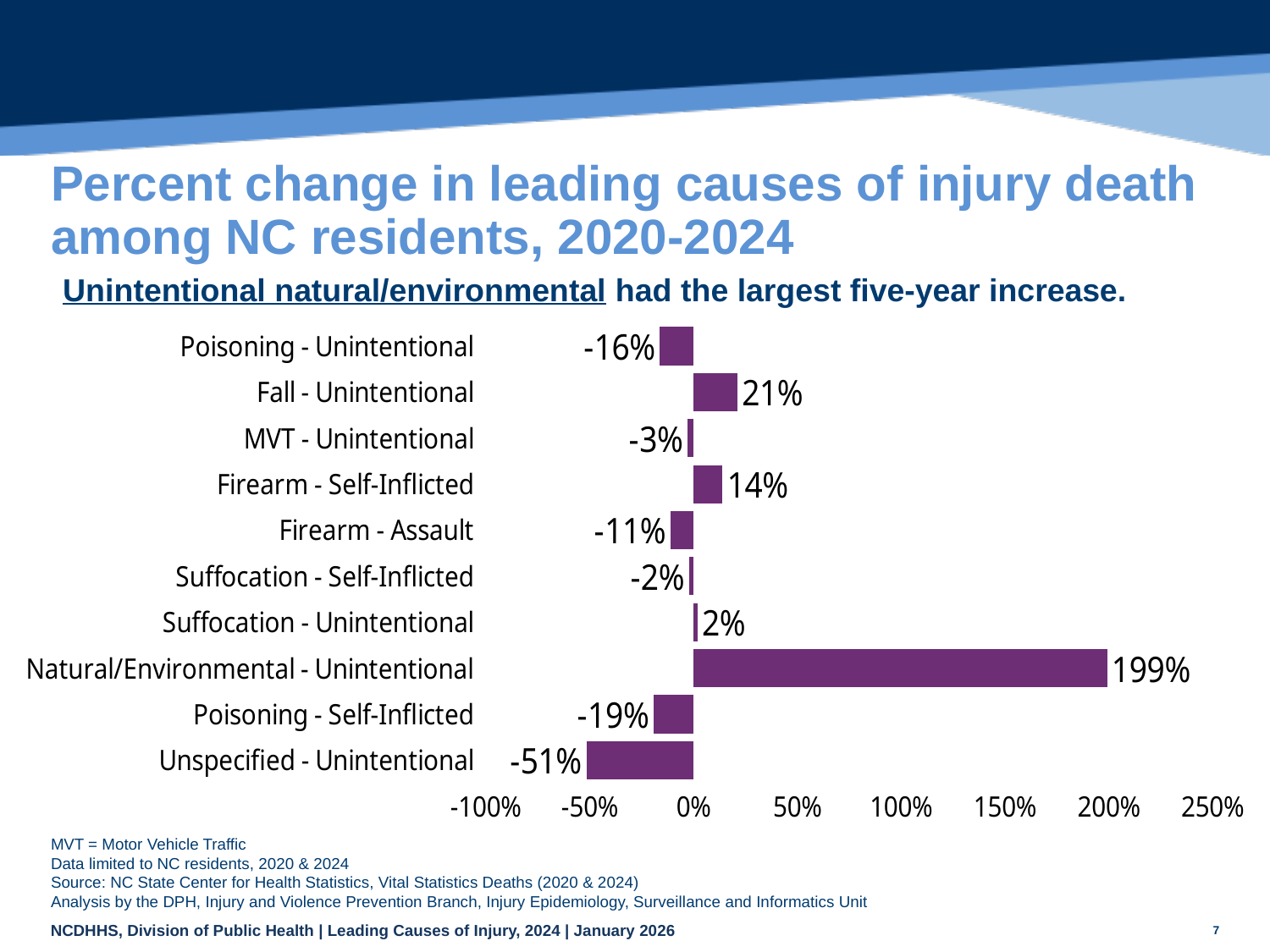
What is the percent change for Fall - Unintentional? 21% Which category has the lowest percent change? Unspecified - Unintentional What is the difference in percentage points between Fall - Unintentional and Firearm - Self-Inflicted? 7 percentage points Is the value for Natural/Environmental - Unintentional greater or less than 150%? greater How many categories are shown in the chart? 10 What is the percent change for Natural/Environmental - Unintentional? 199% Which category has the largest percent change? Natural/Environmental - Unintentional What is the percent change for Poisoning - Self-Inflicted? -19% Which has a larger percent change, Poisoning - Unintentional or Firearm - Assault? Firearm - Assault What kind of chart is shown on the slide? Bar chart What is the percent change for Unspecified - Unintentional? -51% What does MVT stand for according to the slide? Motor Vehicle Traffic